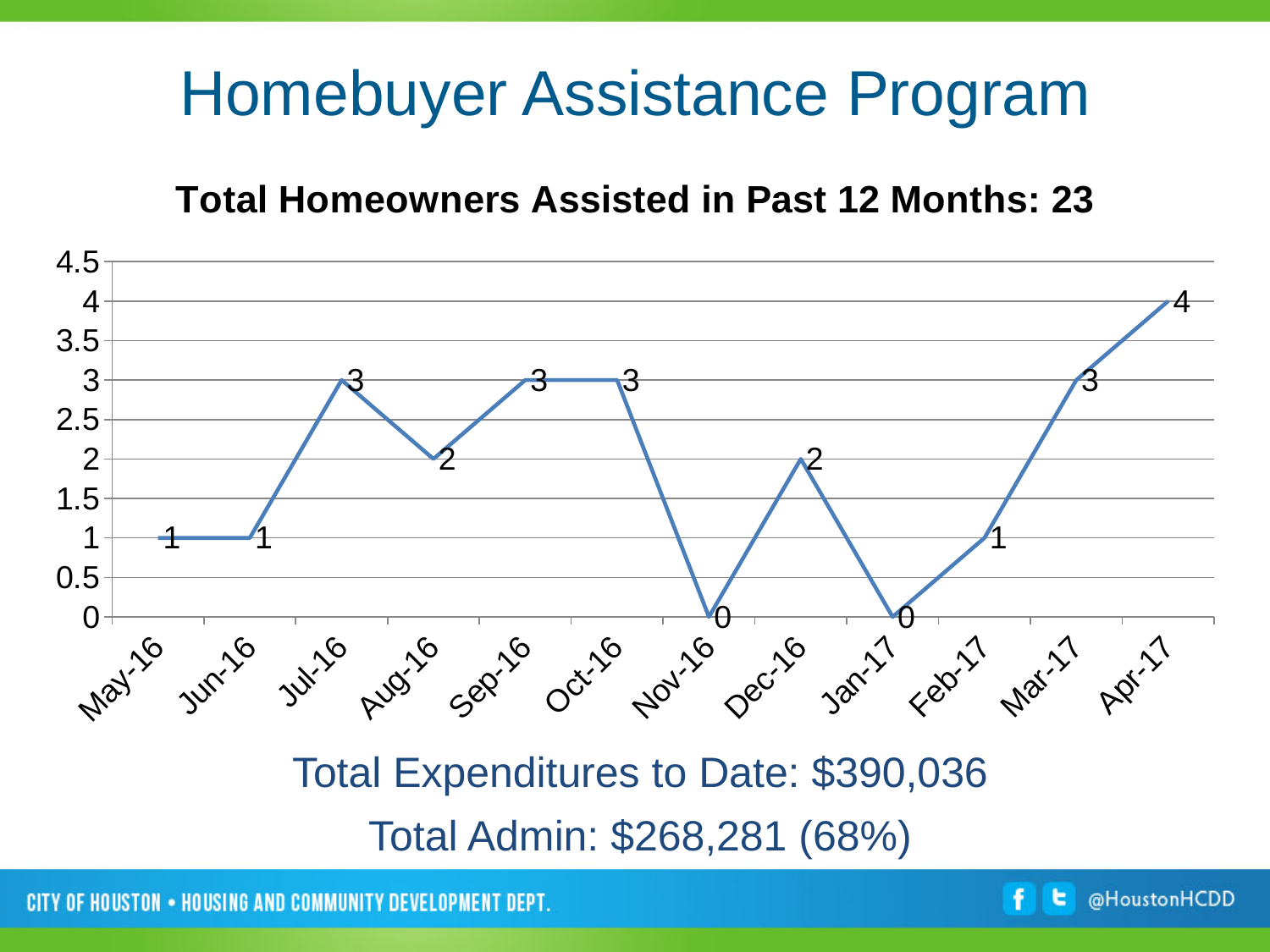
What is the value for Dec-16? 2 What is the value for Jul-16? 3 Do the values rise or fall from Jan-17 to Apr-17? rise Which is larger, the value for Aug-16 or the value for Sep-16? Sep-16 What is the title shown above the chart? Total Homeowners Assisted in Past 12 Months: 23 Which month has the highest value? Apr-17 Which months have a value of 0? Nov-16 and Jan-17 What is the value for Apr-17? 4 What is the difference between the values for Apr-17 and Feb-17? 3 How many months are plotted on the x axis? 12 What kind of chart is shown? line chart What is the value for Aug-16? 2